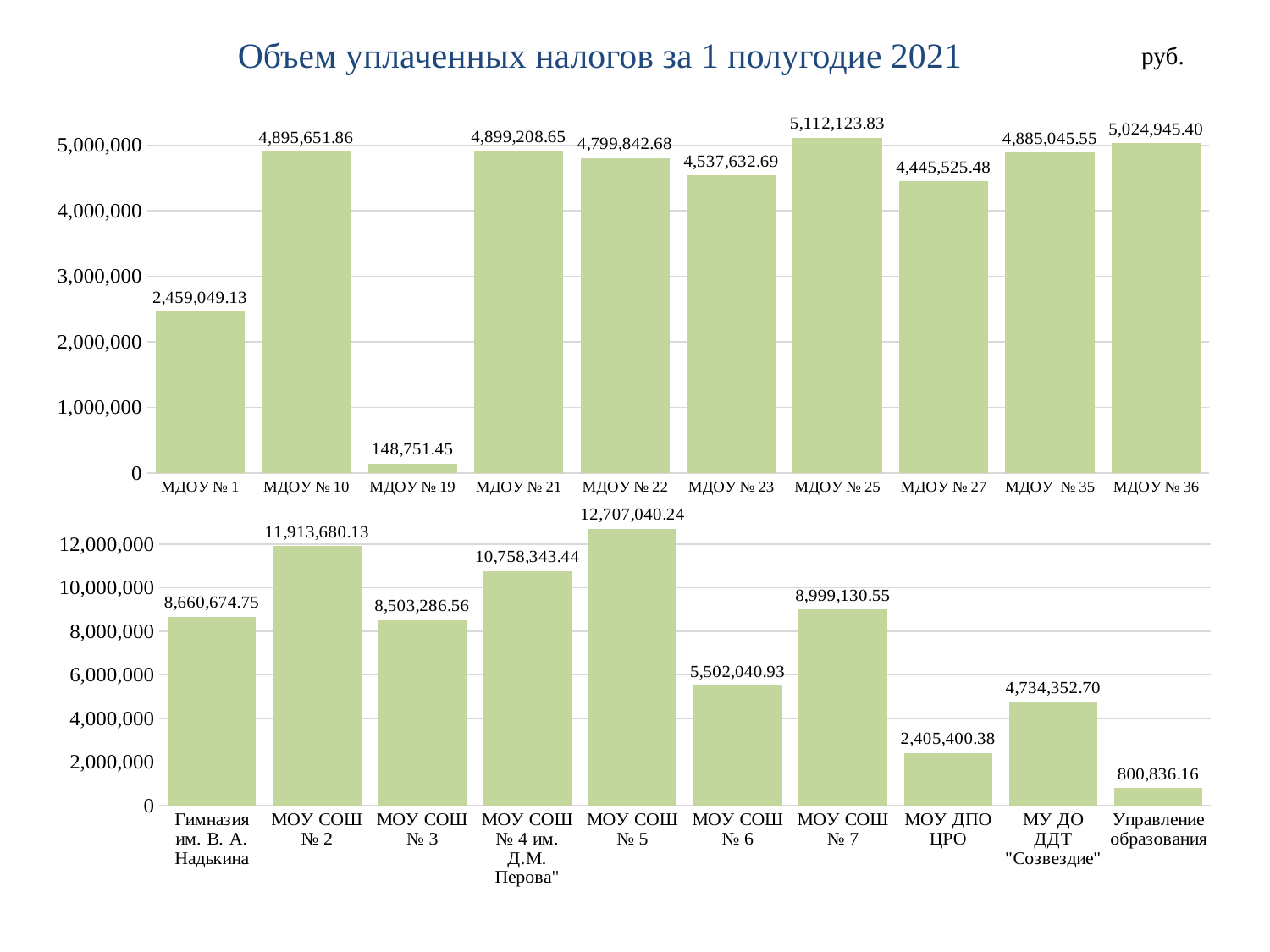
In the top chart, which is larger: the value for МДОУ № 36 or МДОУ № 23? МДОУ № 36 How many categories are shown in the top chart? 10 In the top chart, which category has the lowest value? МДОУ № 19 In the bottom chart, what is the value for МОУ СОШ № 4 им. Д.М. Перова? 10,758,343.44 What type of chart is the bottom chart? bar chart In the top chart, what is the difference between the values for МДОУ № 25 and МДОУ № 1? 2,653,074.70 In the bottom chart, is the value for МОУ СОШ № 6 greater or less than 6,000,000? less In the top chart, what is the value for МДОУ № 25? 5,112,123.83 In the bottom chart, what is the difference between the values for МОУ СОШ № 5 and МОУ СОШ № 2? 793,360.11 In the bottom chart, which category has the lowest value? Управление образования In the top chart, what is the value for МДОУ № 19? 148,751.45 In the bottom chart, which category has the highest value? МОУ СОШ № 5